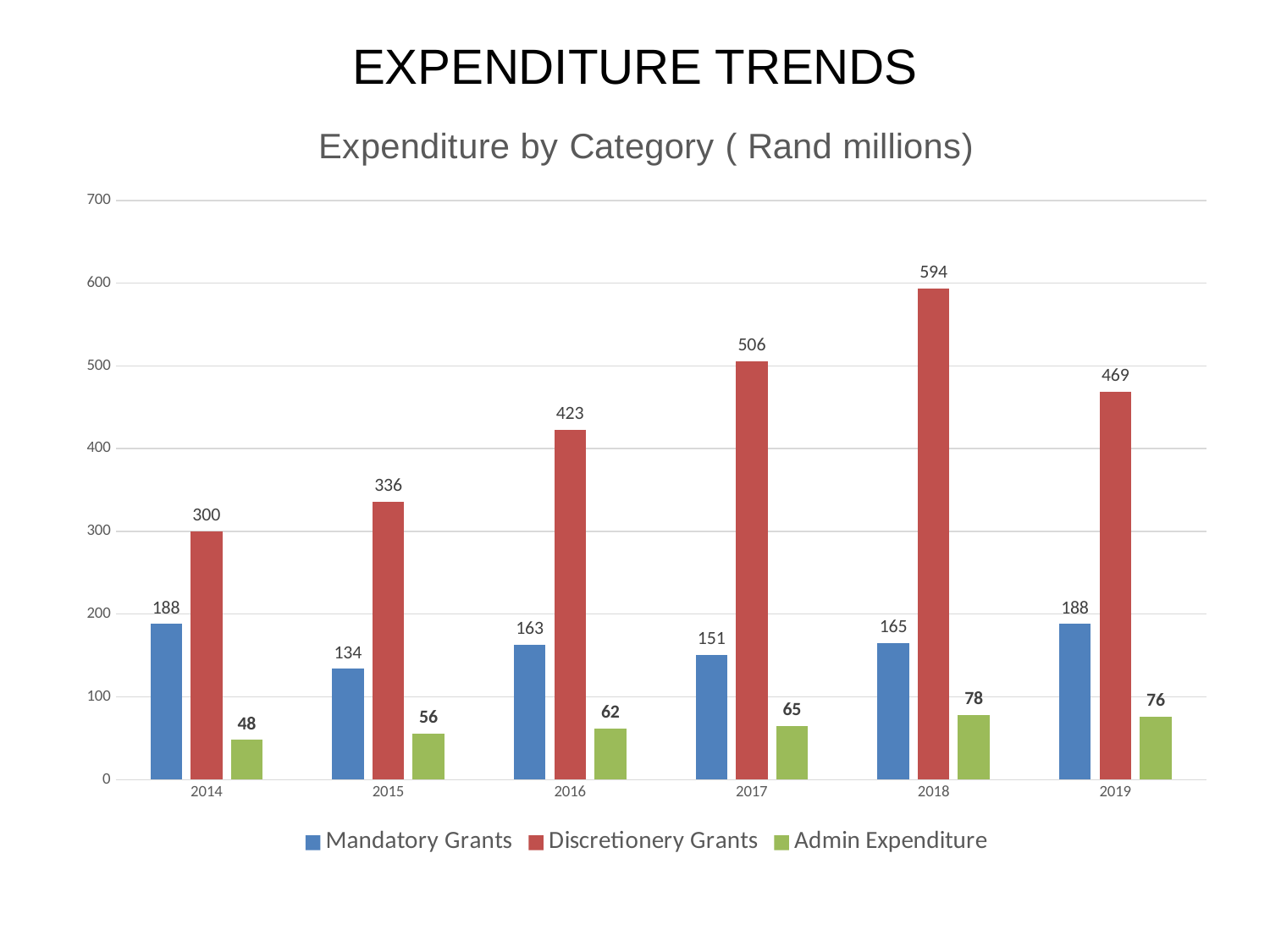
In which year is Discretionery Grants highest? 2018 What is the difference between Discretionery Grants in 2018 and 2019? 125 Which is larger: Mandatory Grants in 2016 or Mandatory Grants in 2017? Mandatory Grants in 2016 What kind of chart is shown on the slide? Bar chart Does Admin Expenditure rise or fall from 2014 to 2018? Rise In which year is Admin Expenditure lowest? 2014 How many years are shown on the x axis? 6 What is the value for Mandatory Grants in 2015? 134 What is the value for Discretionery Grants in 2018? 594 Is the value for Discretionery Grants in 2017 greater or less than 500? greater What is the value for Admin Expenditure in 2019? 76 How many series does the legend list? 3